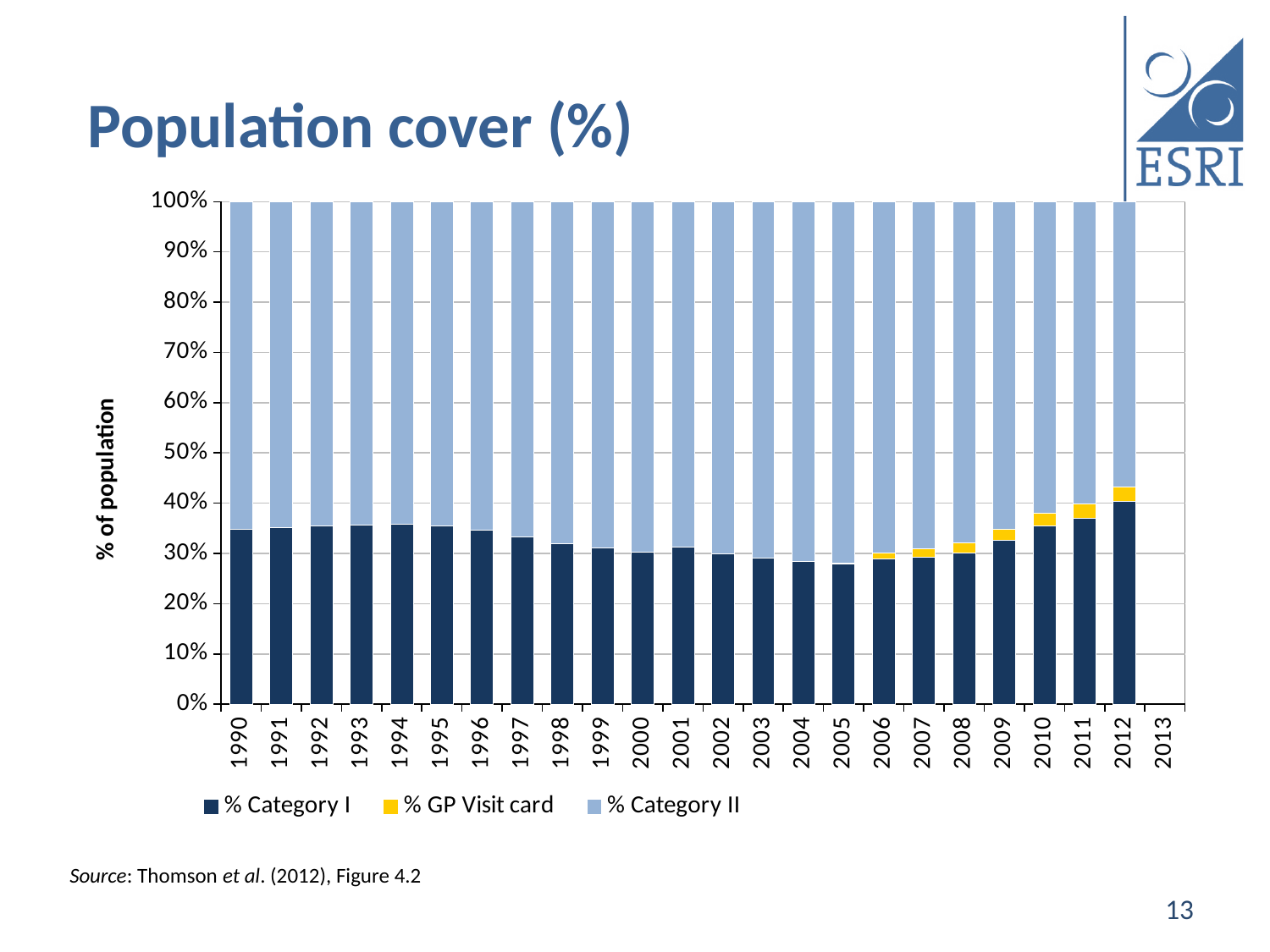
Is the value for % Category II in 2012 greater or less than 50%? greater What is the total of the stacked bar for 2000? 100% How many series does the legend list? 3 Which is larger in 1990, % Category I or % Category II? % Category II What is the label on the vertical axis? % of population What is the title of the chart? Population cover (%) Is the value for % Category I in 2005 greater or less than 30%? less In which year is the % Category I segment the tallest? 2012 Does the % Category I value rise or fall from 2005 to 2012? rise Which year has the larger % Category I value, 2005 or 2012? 2012 What kind of chart is shown on the slide? Stacked bar chart Is the value for % Category I in 1990 greater or less than 30%? greater